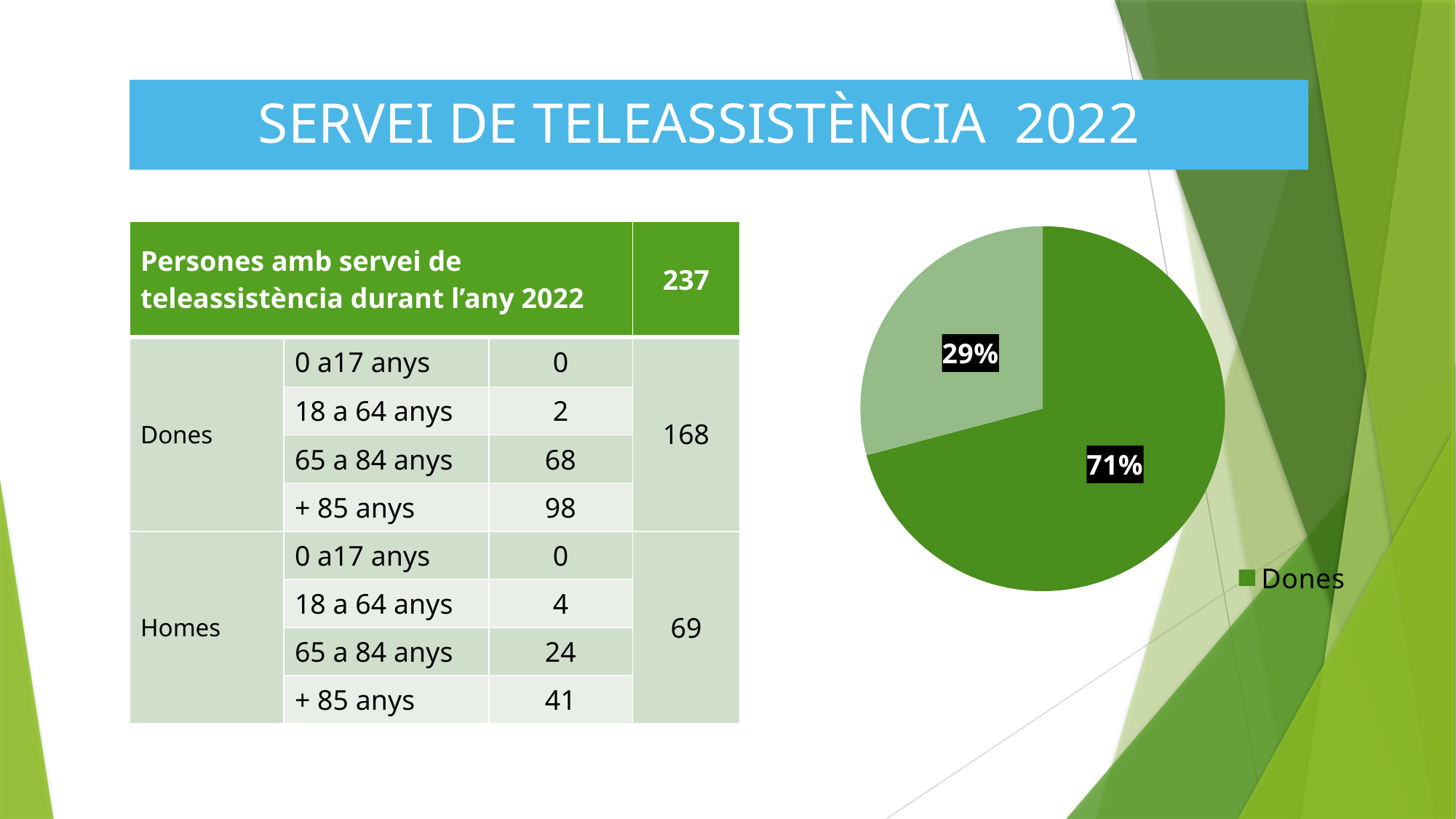
What is the value of the smallest slice in the pie chart? 29% What percentage is printed on the smaller slice of the pie chart? 29% What colour is the Dones slice in the pie chart? dark green Is the Dones slice larger or smaller than the other slice in the pie chart? larger Which legend entry is readable next to the pie chart? Dones What percentage is printed on the larger slice of the pie chart? 71% Which slice of the pie chart is the largest? Dones What is the difference in percentage points between the two slices of the pie chart? 42 What kind of chart is shown on the slide? pie chart How many slices does the pie chart have? 2 What share of the pie chart does the Dones slice represent? 71% Is the share of the Dones slice greater or less than 50%? greater